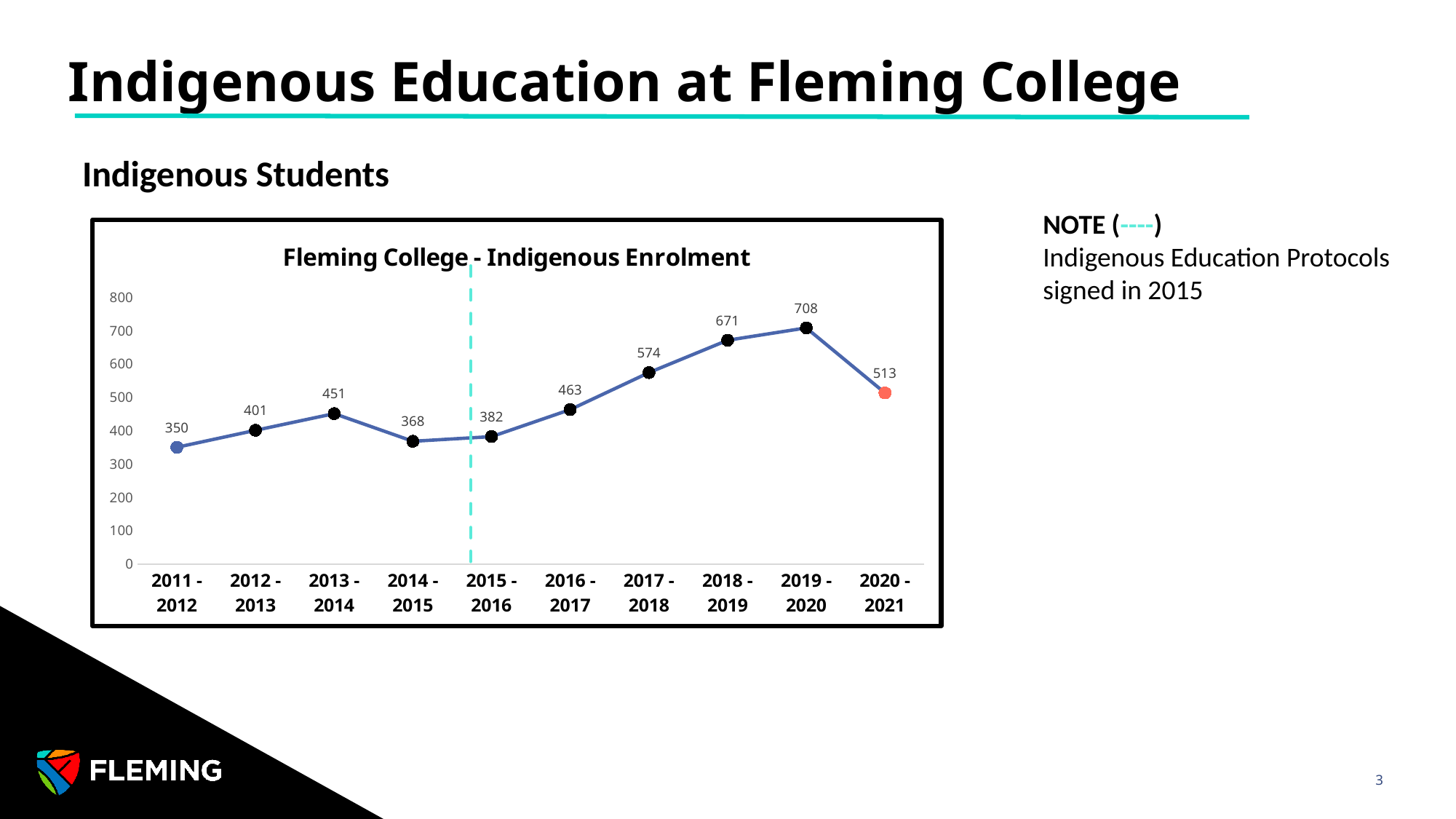
Which year has higher Indigenous enrolment, 2016 - 2017 or 2017 - 2018? 2017 - 2018 Which academic year has the highest Indigenous enrolment? 2019 - 2020 Is the Indigenous enrolment for 2018 - 2019 greater or less than 600? greater What is the difference in Indigenous enrolment between 2013 - 2014 and 2014 - 2015? 83 What kind of chart is shown on the slide? Line chart What is the Indigenous enrolment value for 2015 - 2016? 382 What is the Indigenous enrolment value for 2020 - 2021? 513 What is the Indigenous enrolment value for 2011 - 2012? 350 What is the difference in Indigenous enrolment between 2019 - 2020 and 2020 - 2021? 195 What is the title of the chart? Fleming College - Indigenous Enrolment How many academic years are plotted on the chart? 10 Which academic year has the lowest Indigenous enrolment? 2011 - 2012